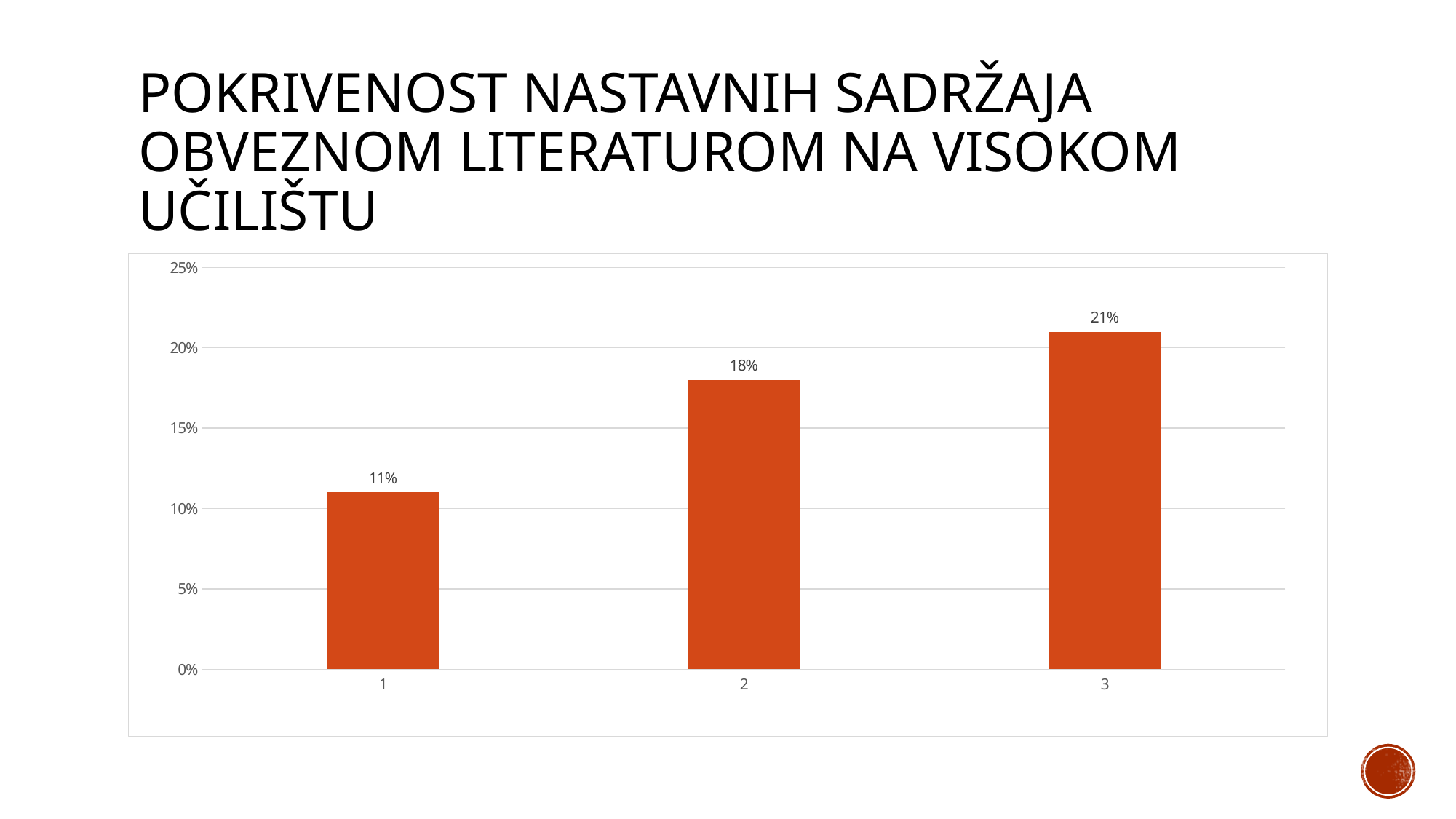
What is the value for category 1? 11% Which is larger, the value for category 2 or the value for category 3? category 3 Which category has the highest value? 3 Which category has the lowest value? 1 What is the value for category 3? 21% What is the difference between the values for category 2 and category 1? 7% What is the difference between the values for category 3 and category 1? 10% What kind of chart is shown on the slide? bar chart Do the values rise or fall from category 1 to category 3? rise How many bars are shown in the chart? 3 What is the value for category 2? 18% Is the value for category 2 greater or less than 15%? greater